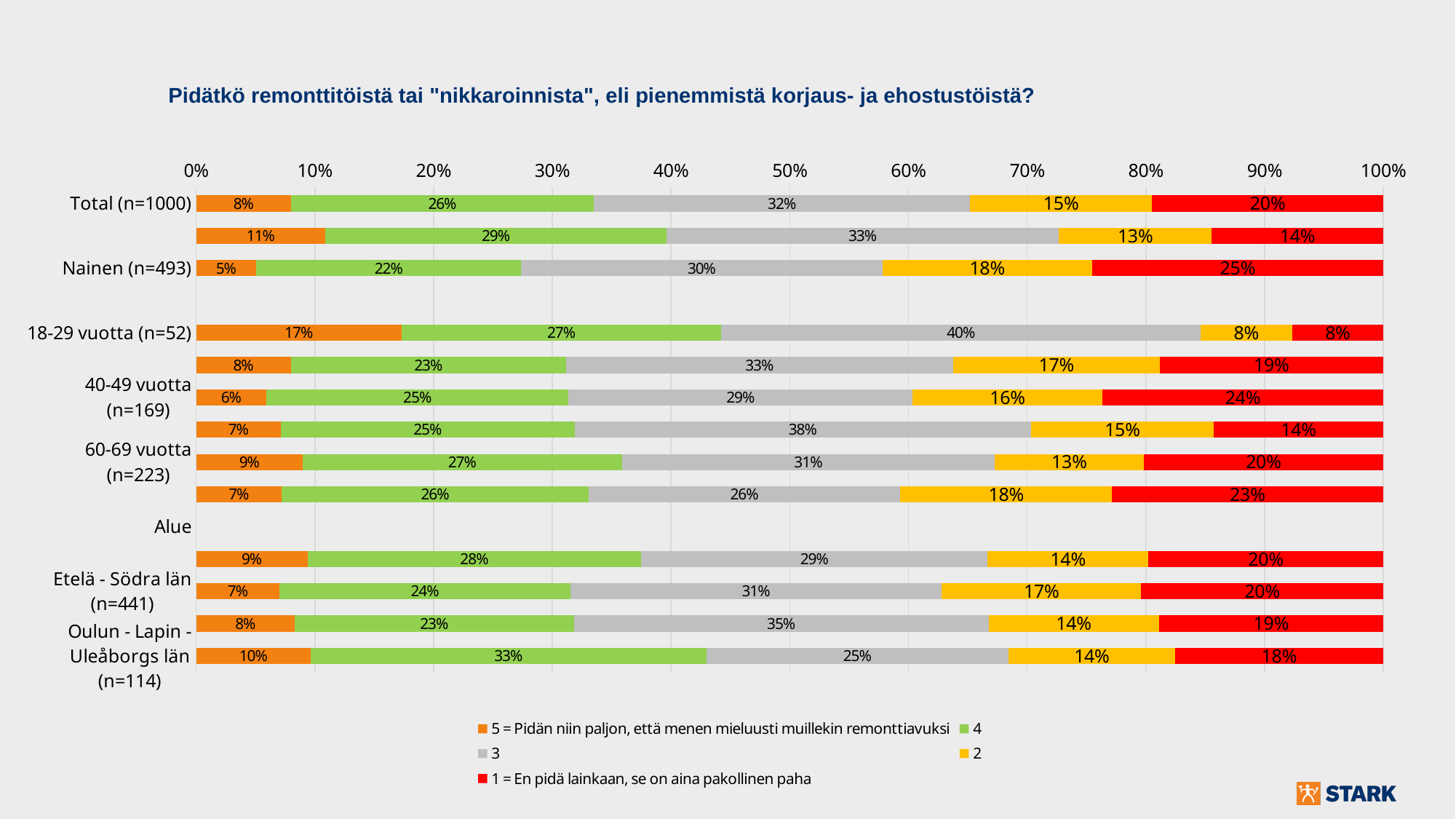
What is the difference between the red '1' segment for Nainen (n=493) and for Total (n=1000)? 5% Which segment is the largest in the Total (n=1000) bar? 3 What is the value of the '2' (yellow) segment for Total (n=1000)? 15% What is the value of the '3' (grey) segment for 18-29 vuotta (n=52)? 40% What is the value of the '5 = Pidän niin paljon, että menen mieluusti muillekin remonttiavuksi' (orange) segment for 18-29 vuotta (n=52)? 17% What is the value of the '1 = En pidä lainkaan, se on aina pakollinen paha' (red) segment for Nainen (n=493)? 25% What is the title of the chart? Pidätkö remonttitöistä tai "nikkaroinnista", eli pienemmistä korjaus- ja ehostustöistä? Which segment is the smallest in the Nainen (n=493) bar? 5 = Pidän niin paljon, että menen mieluusti muillekin remonttiavuksi What is the value of the '3' (grey) segment for Total (n=1000)? 32% Which is larger: the orange '5' segment for 18-29 vuotta (n=52) or for Nainen (n=493)? 18-29 vuotta (n=52) How many series does the legend list? 5 What kind of chart is shown on the slide? Stacked bar chart